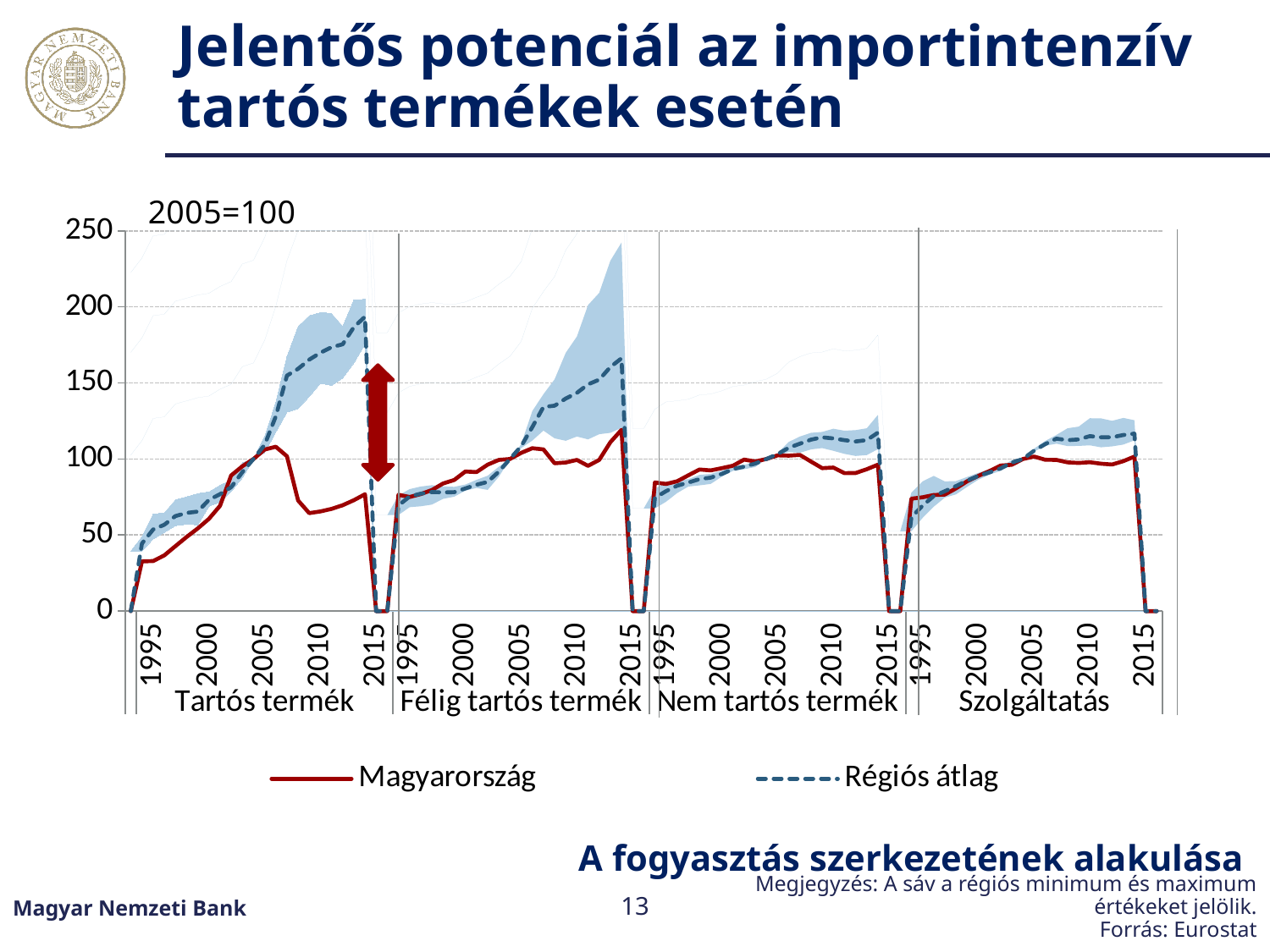
In the Tartós termék panel, does the Magyarország line rise or fall between 2005 and 2010? fall What base year and value is indicated above the chart? 2005=100 In the Tartós termék panel, is the value of Magyarország around 2014 greater or less than 100? less In the Félig tartós termék panel, is the value of Régiós átlag around 2014 greater or less than 150? greater How many series does the legend list? 2 In the Szolgáltatás panel, is the value of Régiós átlag around 2014 greater or less than 100? greater In the Tartós termék panel, which series is higher around 2014, Magyarország or Régiós átlag? Régiós átlag Which series is drawn as a dashed line in the legend? Régiós átlag In the Tartós termék panel, does the Régiós átlag line rise or fall between 1995 and 2014? rise How many product-category panels does the chart contain? 4 What kind of chart is shown on the slide? line chart